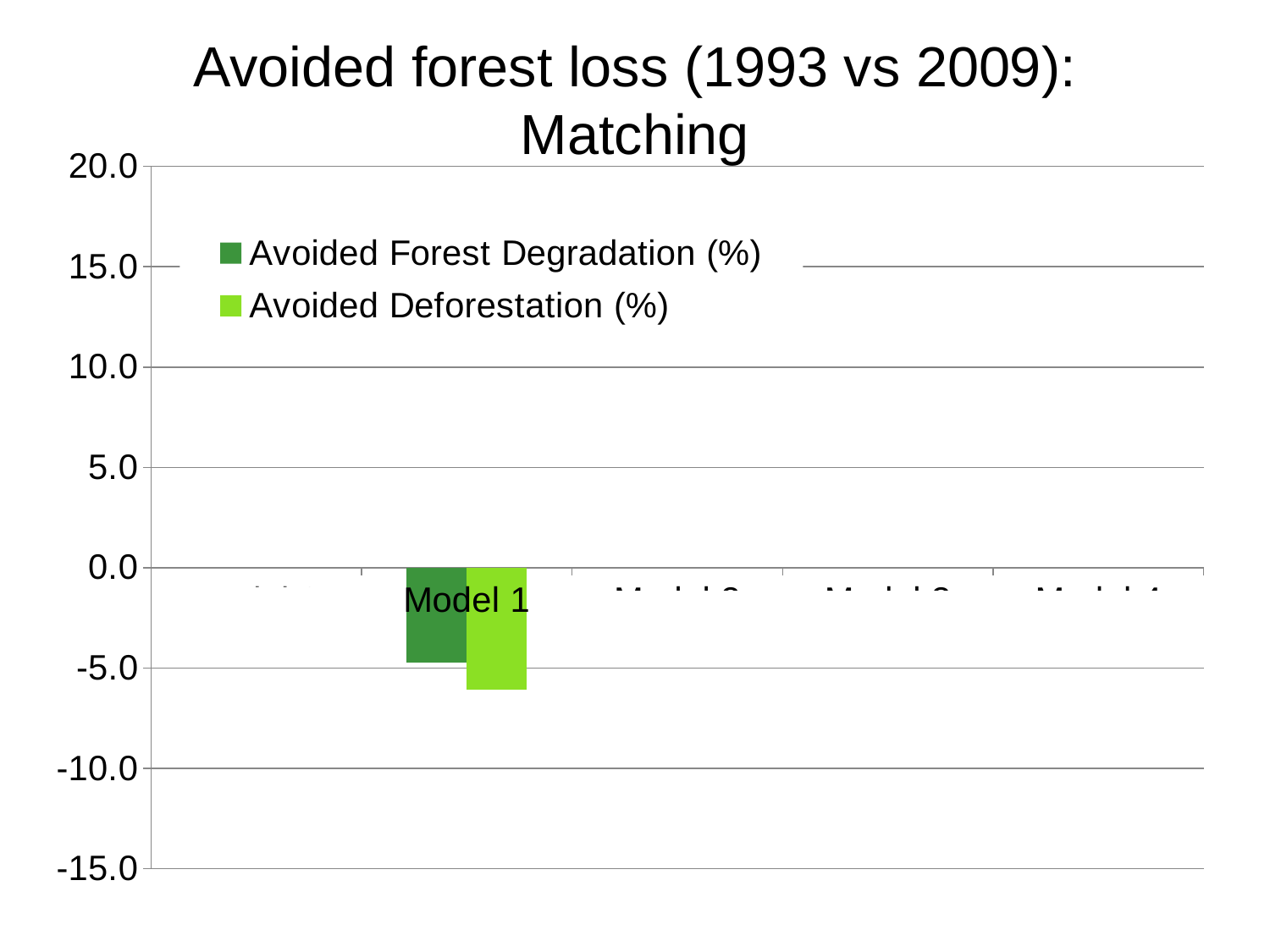
Is the value for Avoided Forest Degradation (%) for Model 1 greater or less than 0.0? less What is the title of the chart? Avoided forest loss (1993 vs 2009): Matching Is the value for Avoided Forest Degradation (%) for Model 1 greater or less than -10.0? greater Is the value for Avoided Deforestation (%) for Model 1 greater or less than -5.0? less How many series does the legend list? 2 For Model 1, which series has the lower (more negative) value, Avoided Forest Degradation (%) or Avoided Deforestation (%)? Avoided Deforestation (%) Which series is shown in the lighter green colour? Avoided Deforestation (%) What kind of chart is shown on the slide? bar chart For Model 1, which series has the higher value, Avoided Forest Degradation (%) or Avoided Deforestation (%)? Avoided Forest Degradation (%)